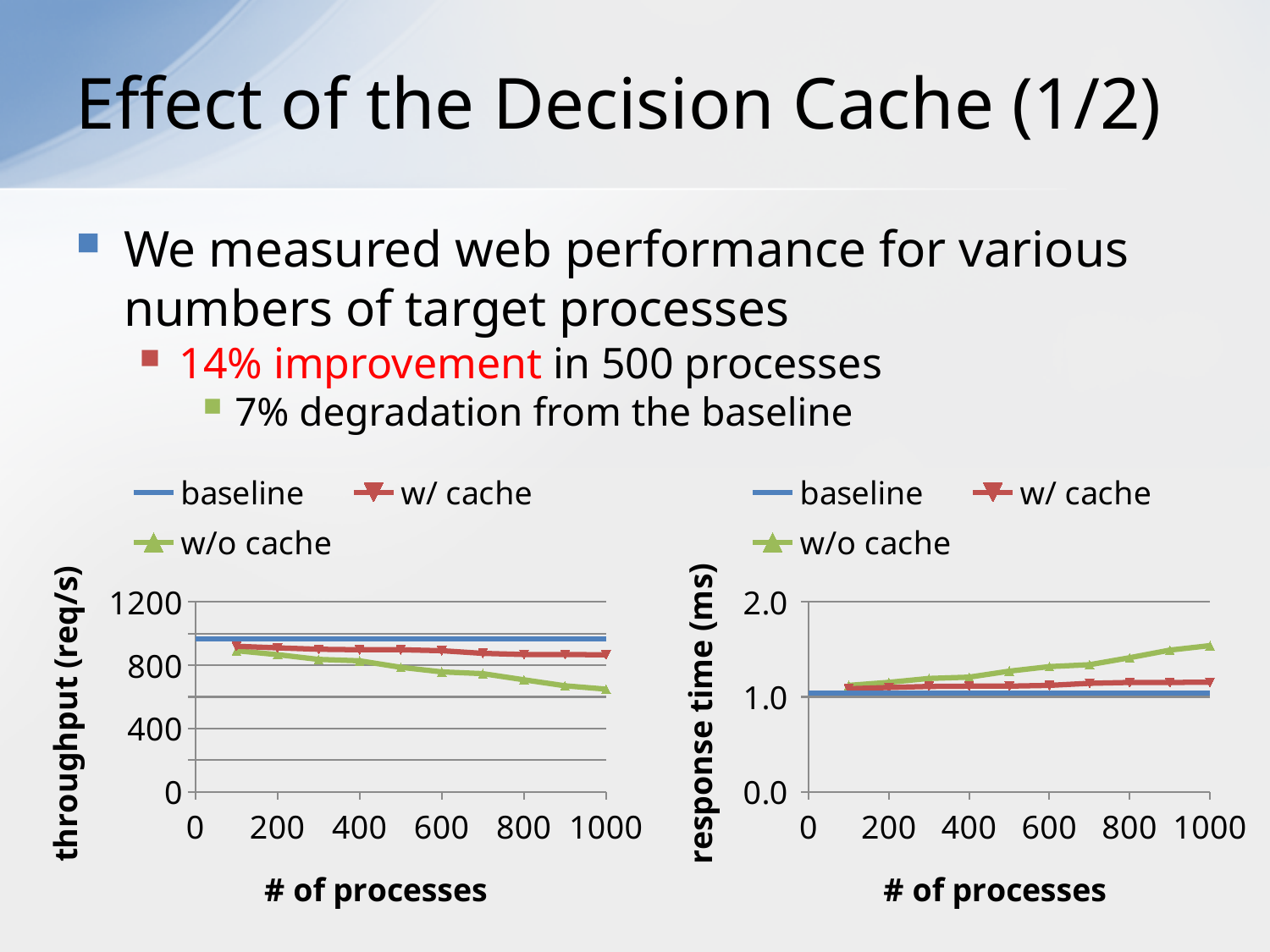
In the throughput (req/s) chart on the left, does the w/o cache series rise or fall as the number of processes increases? fall What kind of chart is the throughput (req/s) chart on the left? line chart In the throughput (req/s) chart on the left, is the w/o cache value at 1000 processes greater or less than 800? less In the response time (ms) chart on the right, is the w/o cache value at 1000 processes greater or less than 1.0? greater In the response time (ms) chart on the right, is the w/o cache value at 1000 processes greater or less than 2.0? less In the throughput (req/s) chart on the left, which series is higher at 1000 processes, w/ cache or w/o cache? w/ cache What is the x-axis title of the response time (ms) chart on the right? # of processes In the response time (ms) chart on the right, does the w/o cache series rise or fall as the number of processes increases? rise In the response time (ms) chart on the right, which series is higher at 1000 processes, w/ cache or w/o cache? w/o cache In the throughput (req/s) chart on the left, which series has the lowest value at 1000 processes? w/o cache How many series does the legend of the response time (ms) chart on the right list? 3